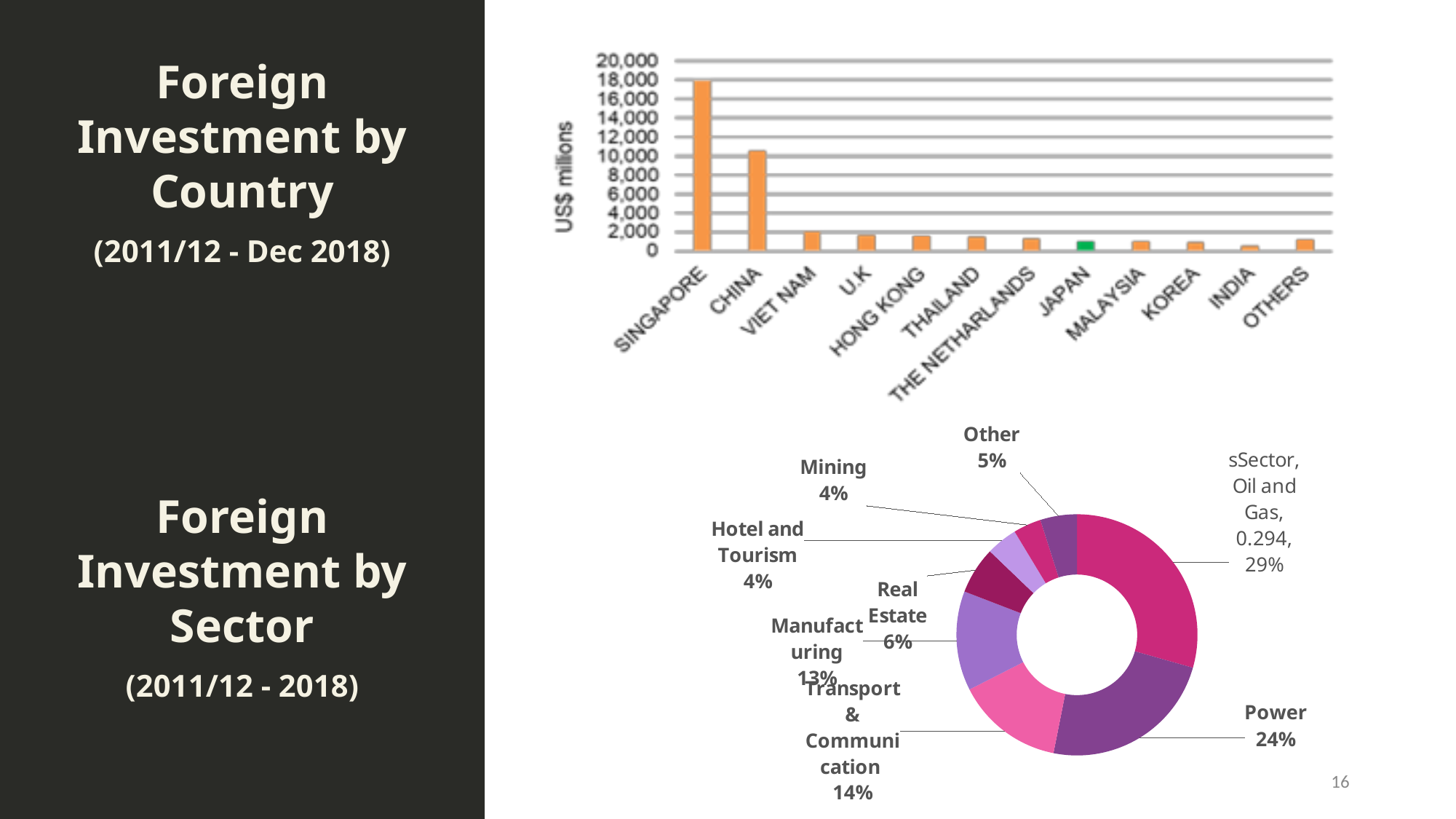
In the Foreign Investment by Sector chart, what is the difference between the Oil and Gas share and the Power share? 5% In the Foreign Investment by Country chart, is the value for Singapore greater or less than 16,000? greater How many countries/categories are shown in the Foreign Investment by Country chart? 12 In the Foreign Investment by Sector chart, what share does Power have? 24% How many sectors are shown in the Foreign Investment by Sector chart? 8 What kind of chart is the Foreign Investment by Country chart? Bar chart In the Foreign Investment by Country chart, which country has the lowest investment? India In the Foreign Investment by Country chart, is the value for China greater or less than 8,000? greater In the Foreign Investment by Country chart, which country has the highest investment? Singapore In the Foreign Investment by Country chart, which has a larger value, China or Viet Nam? China In the Foreign Investment by Sector chart, which sector has the largest share? Oil and Gas In the Foreign Investment by Country chart, is the value for Japan greater or less than 2,000? less